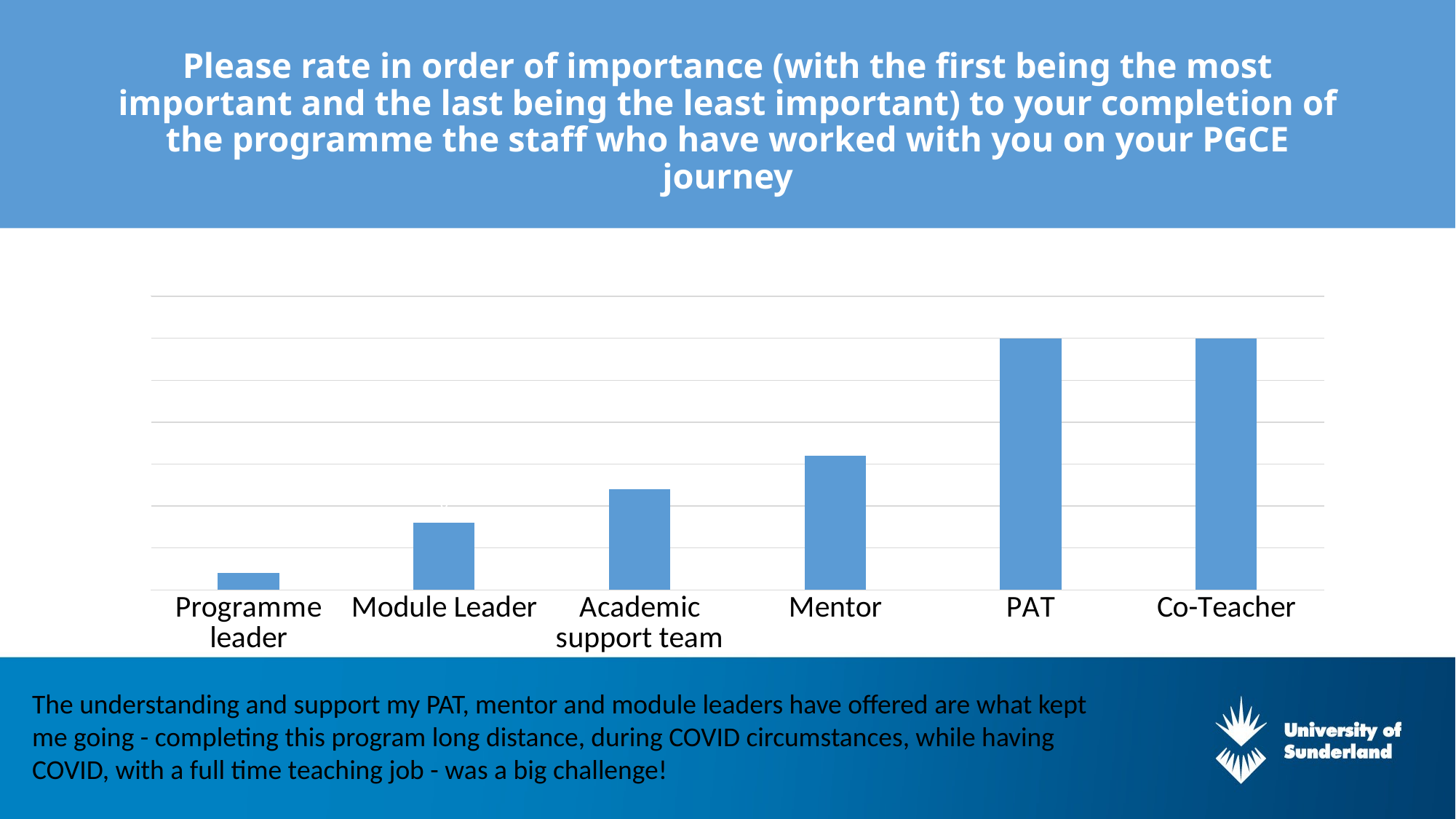
Which is larger, the value for PAT or the value for Mentor? PAT Which category has the lowest bar in the chart? Programme leader Which category is plotted immediately to the right of Mentor? PAT Which is larger, the value for Academic support team or the value for Programme leader? Academic support team What colour are the bars in the chart? blue Which is larger, the value for Module Leader or the value for Academic support team? Academic support team What kind of chart is shown on the slide? bar chart Do the bar values generally rise or fall moving from left to right along the x axis? rise How many categories are shown on the x axis of the chart? 6